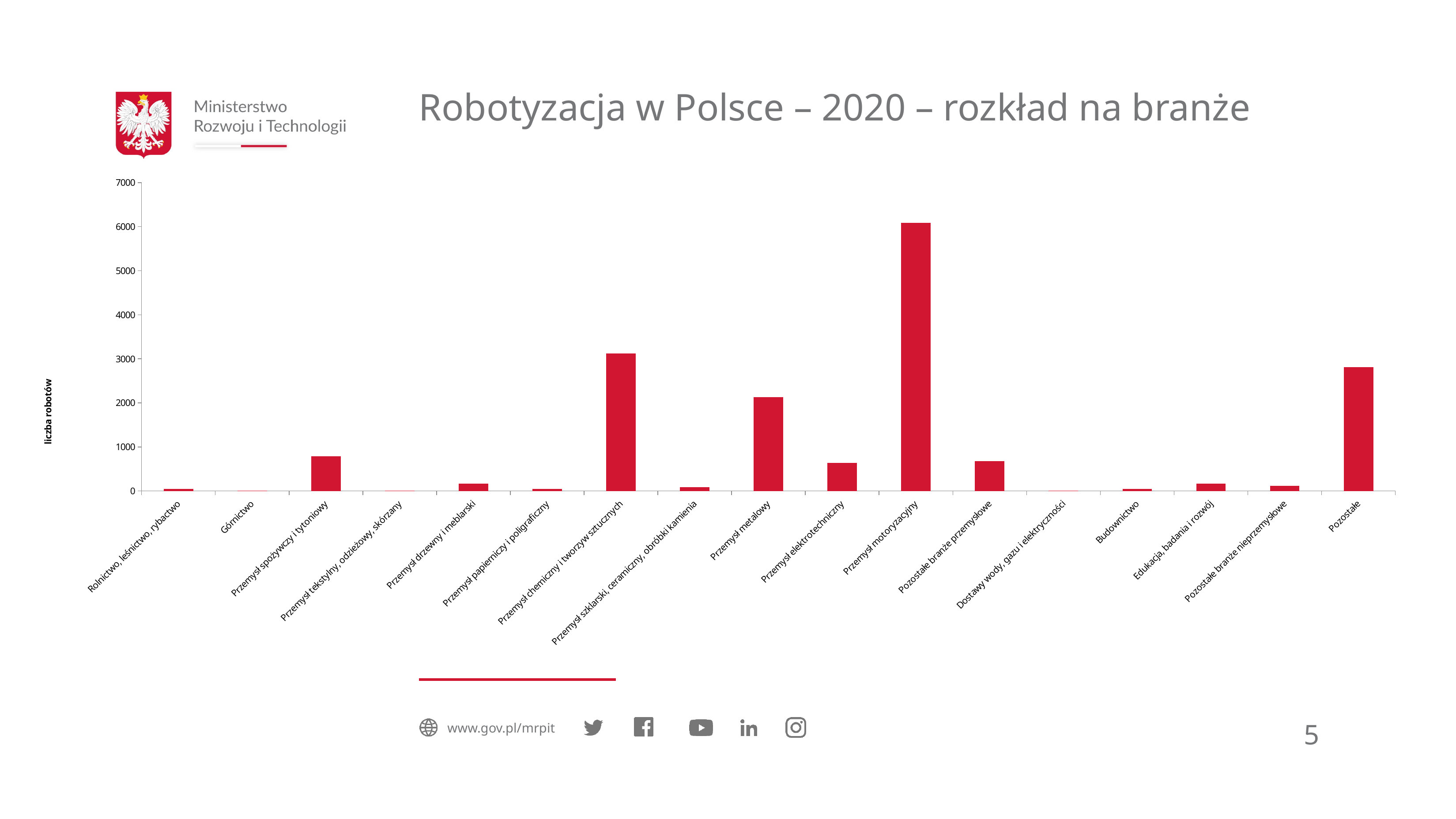
Is the value for Przemysł metalowy greater or less than 1000? greater How many industry categories are plotted on the x axis? 17 Which is larger, the value for Przemysł chemiczny i tworzyw sztucznych or for Przemysł metalowy? Przemysł chemiczny i tworzyw sztucznych Is the value for Przemysł chemiczny i tworzyw sztucznych greater or less than 2000? greater What is the label of the vertical axis? liczba robotów Is the value for Przemysł motoryzacyjny greater or less than 5000? greater What is the title of the slide containing the chart? Robotyzacja w Polsce – 2020 – rozkład na branże Which category has the highest number of robots? Przemysł motoryzacyjny Which is larger, the value for Pozostałe or for Przemysł elektrotechniczny? Pozostałe What kind of chart is shown on the slide? bar chart